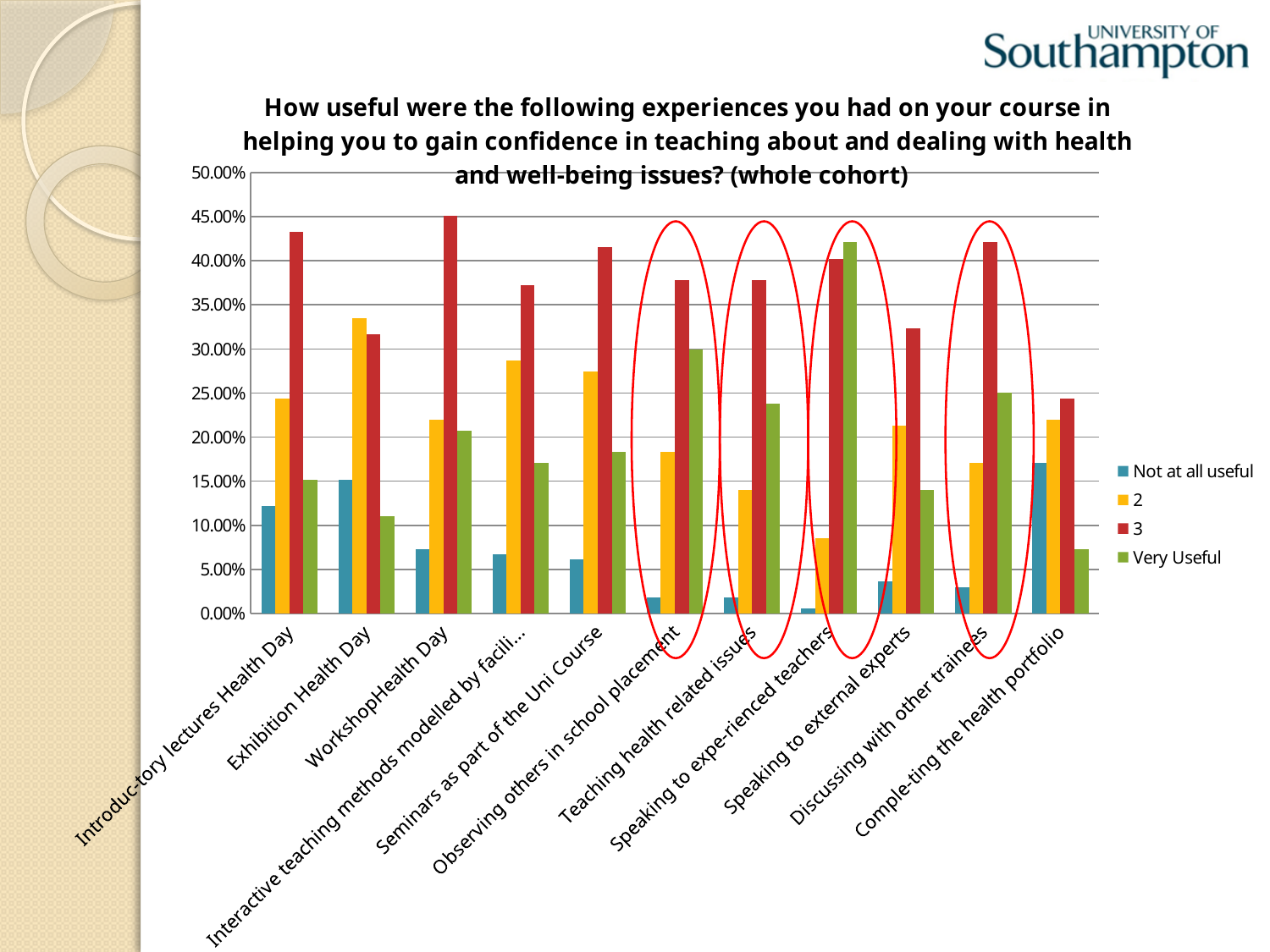
Is the '3' value for WorkshopHealth Day greater or less than 40.00%? greater For Introduc-tory lectures Health Day, which is larger: the '3' value or the '2' value? 3 Which category has the highest value for the '2' series? Exhibition Health Day Is the '2' value for Exhibition Health Day greater or less than 30.00%? greater Is the 'Very Useful' value for Comple-ting the health portfolio greater or less than 10.00%? less Which category has the lowest value for the 'Not at all useful' series? Speaking to expe-rienced teachers How many categories are circled in red on the chart? 4 Which category has the highest value for the 'Very Useful' series? Speaking to expe-rienced teachers How many course experience categories are shown on the x axis? 11 For Comple-ting the health portfolio, which is larger: the 'Not at all useful' value or the 'Very Useful' value? Not at all useful How many series does the legend list? 4 What kind of chart is shown on the slide? bar chart